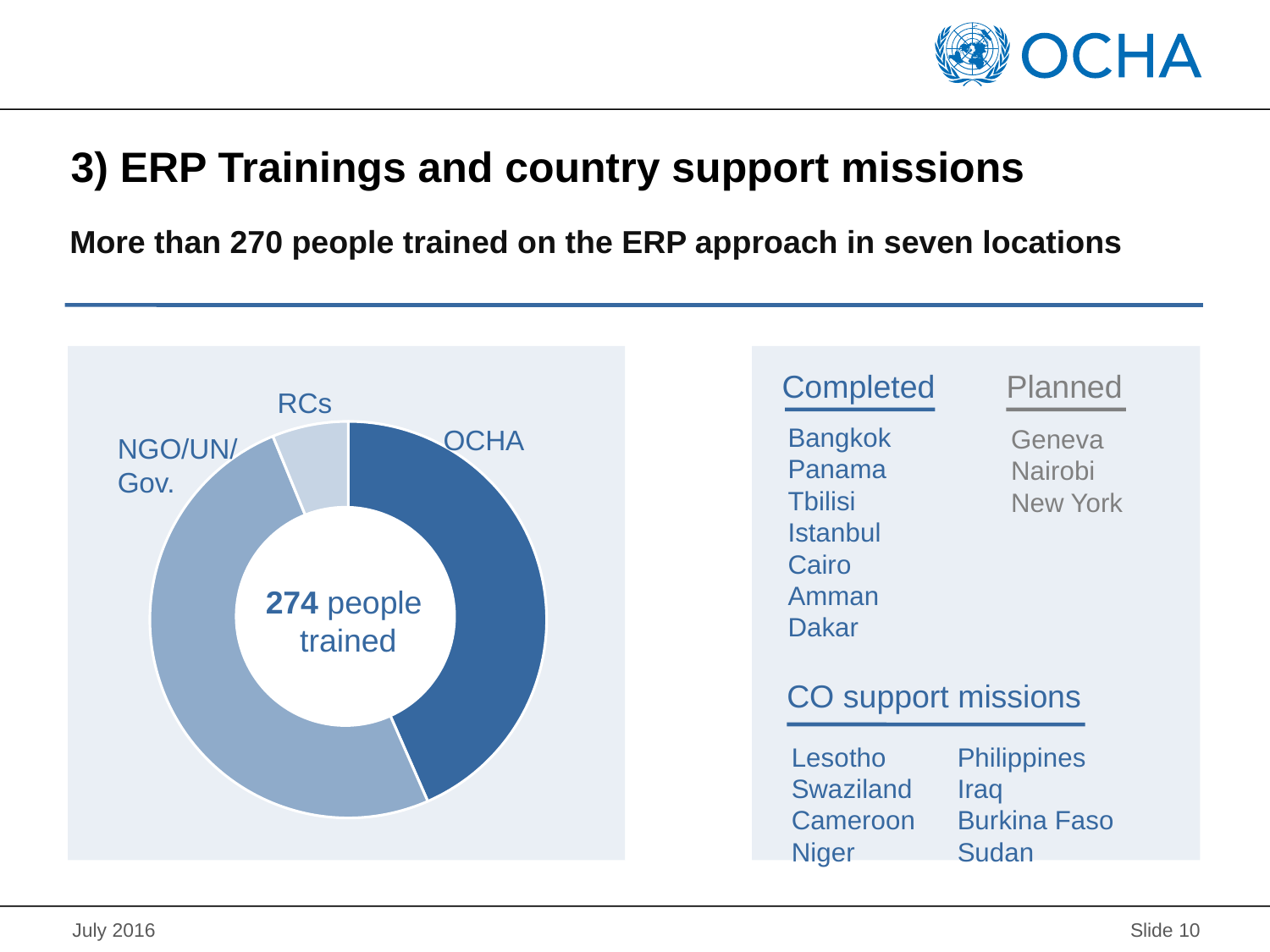
What colour is the OCHA segment of the donut chart? Dark blue Which category has the smallest segment in the donut chart? RCs Which segment is larger in the donut chart, RCs or OCHA? OCHA Which segment is larger in the donut chart, NGO/UN/Gov. or RCs? NGO/UN/Gov. What kind of chart is shown on the slide? Donut chart How many categories does the donut chart show? 3 What total number of people trained is shown in the centre of the donut chart? 274